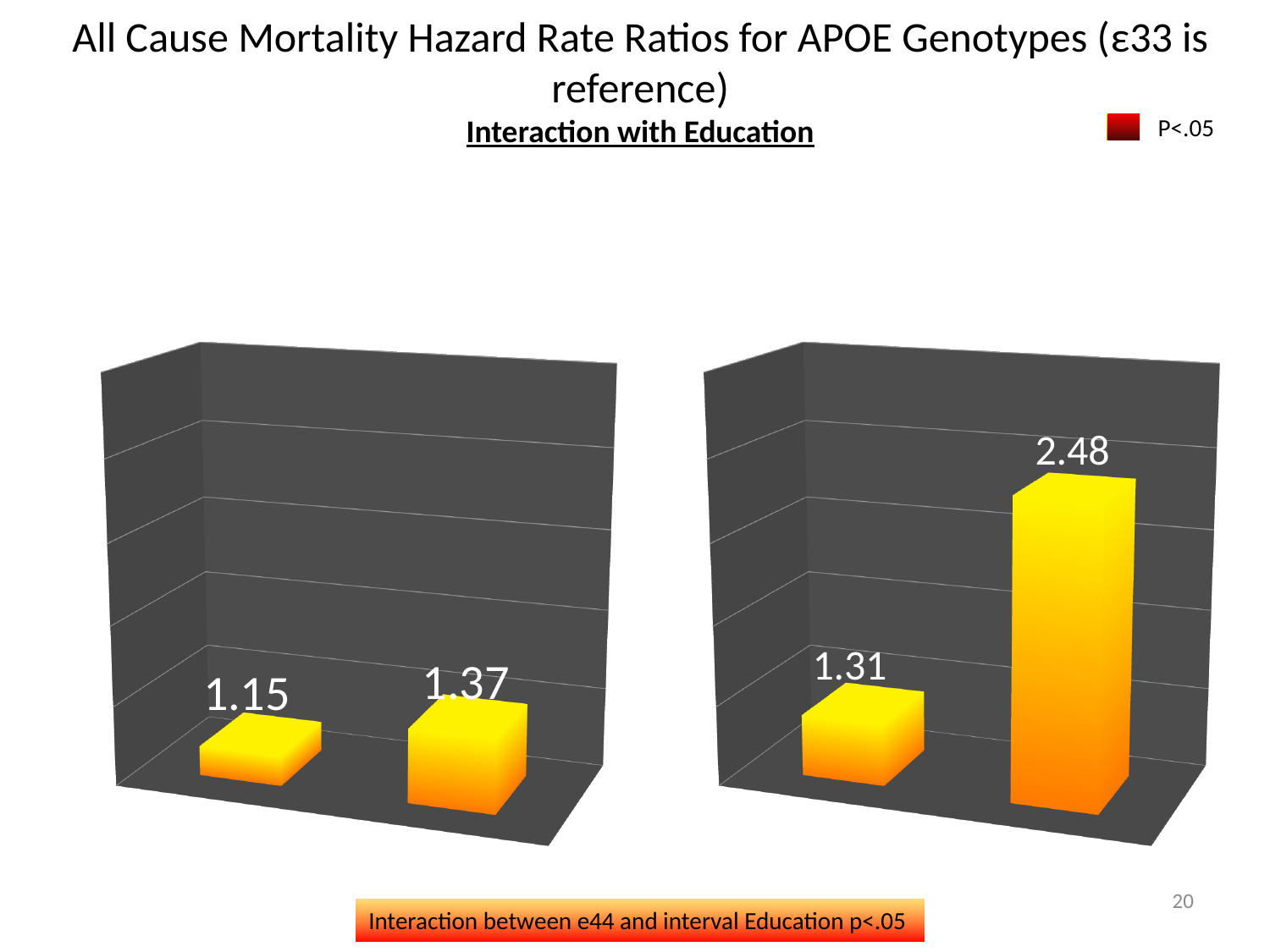
In the left chart, what is the value shown on the right bar? 1.37 In the left chart, what is the value shown on the left bar? 1.15 In the right chart, what is the value shown on the right bar? 2.48 In the right chart, what is the value shown on the left bar? 1.31 In the left chart, what is the lowest value shown? 1.15 In the left chart, which bar is taller, the left bar or the right bar? the right bar How many bars are plotted in the right chart? 2 In the right chart, what is the highest value shown? 2.48 In the right chart, what is the difference between the right bar and the left bar? 1.17 In the right chart, do the values rise or fall from left to right? rise In the left chart, what is the difference between the right bar and the left bar? 0.22 What type of chart is the left chart? bar chart